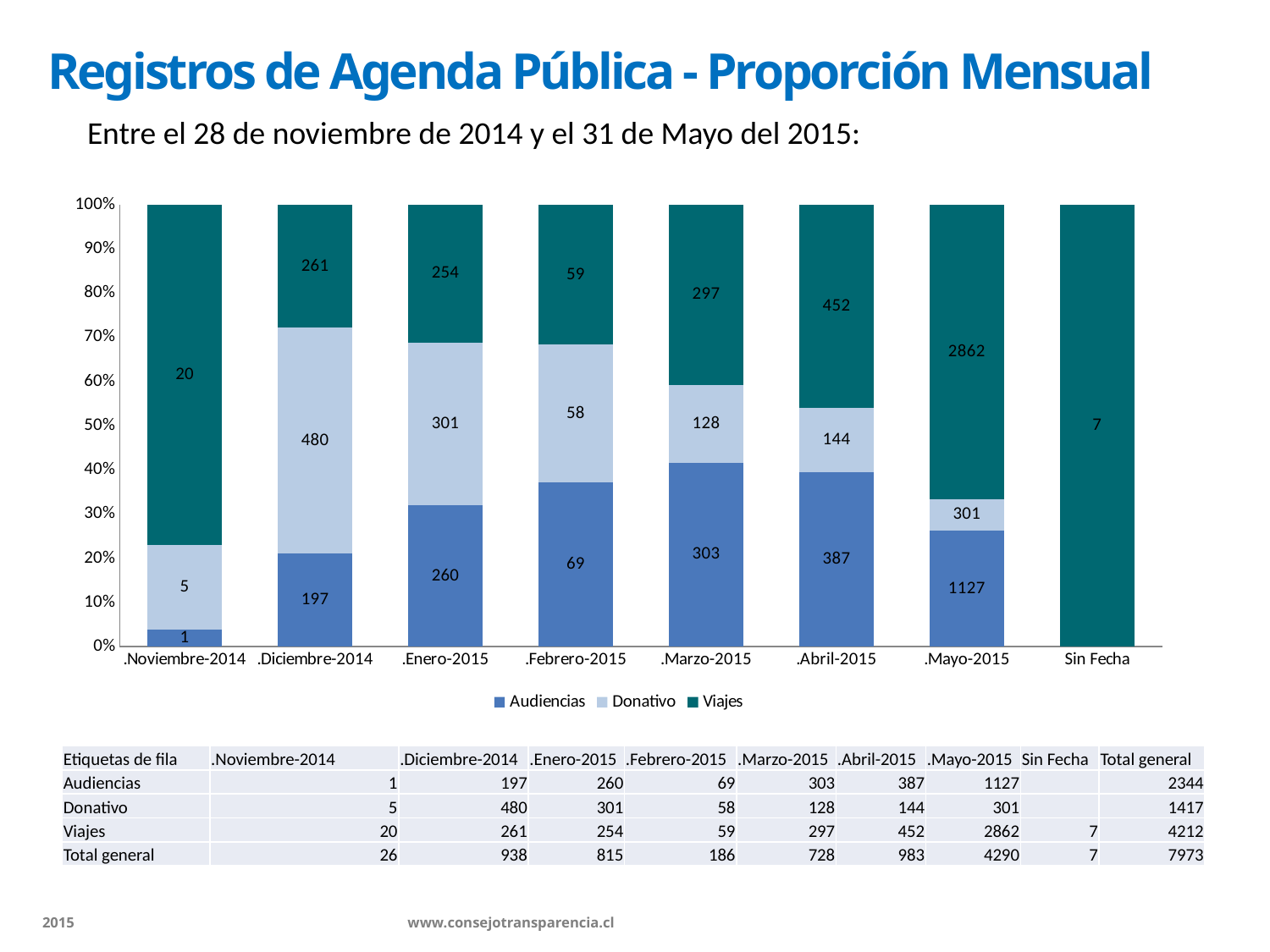
What is the value for Audiencias in Abril-2015? 387 What is the value for Viajes in Mayo-2015? 2862 What is the difference between the Viajes values for Abril-2015 and Marzo-2015? 155 Which is larger, the Donativo value for Enero-2015 or for Febrero-2015? Enero-2015 What is the title of the slide containing the chart? Registros de Agenda Pública - Proporción Mensual How many categories are shown on the x axis? 8 What kind of chart is shown on the slide? Stacked bar chart Which category has the highest Viajes value? Mayo-2015 How many series does the legend list? 3 Which month has the lowest Donativo value? Noviembre-2014 What is the total of the three values in the Diciembre-2014 bar? 938 What is the value for Donativo in Diciembre-2014? 480